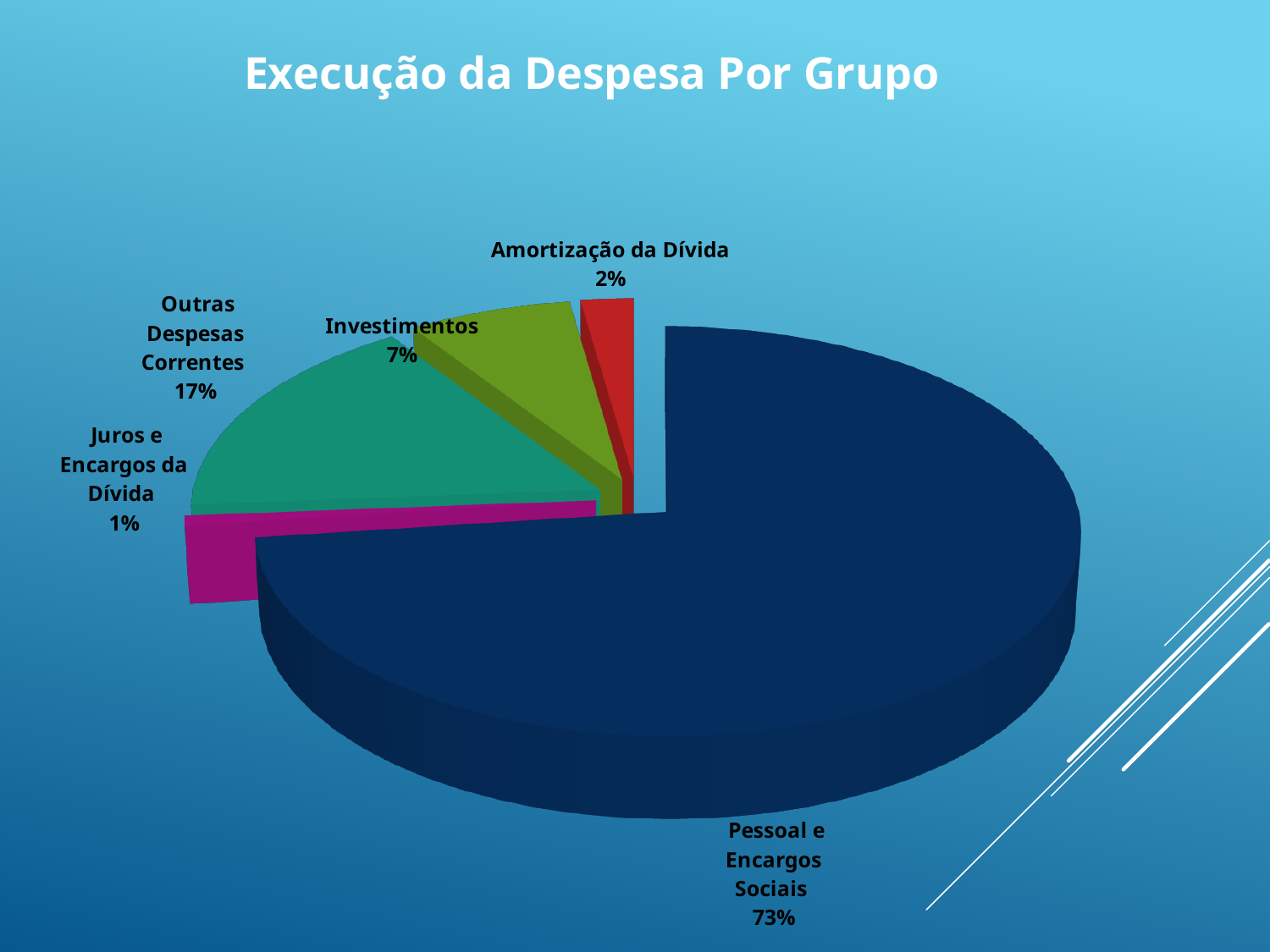
What is the value shown for Juros e Encargos da Dívida? 1% What share of the pie does Pessoal e Encargos Sociais represent? 73% Which is larger, Investimentos or Amortização da Dívida? Investimentos What is the title of the chart? Execução da Despesa Por Grupo What is the value shown for Amortização da Dívida? 2% Which category has the smallest slice of the pie? Juros e Encargos da Dívida What is the value shown for Investimentos? 7% How many categories are shown in the pie chart? 5 What is the value shown for Outras Despesas Correntes? 17% What kind of chart is shown on the slide? Pie chart Which category has the largest slice of the pie? Pessoal e Encargos Sociais What is the difference in percentage points between Outras Despesas Correntes and Investimentos? 10